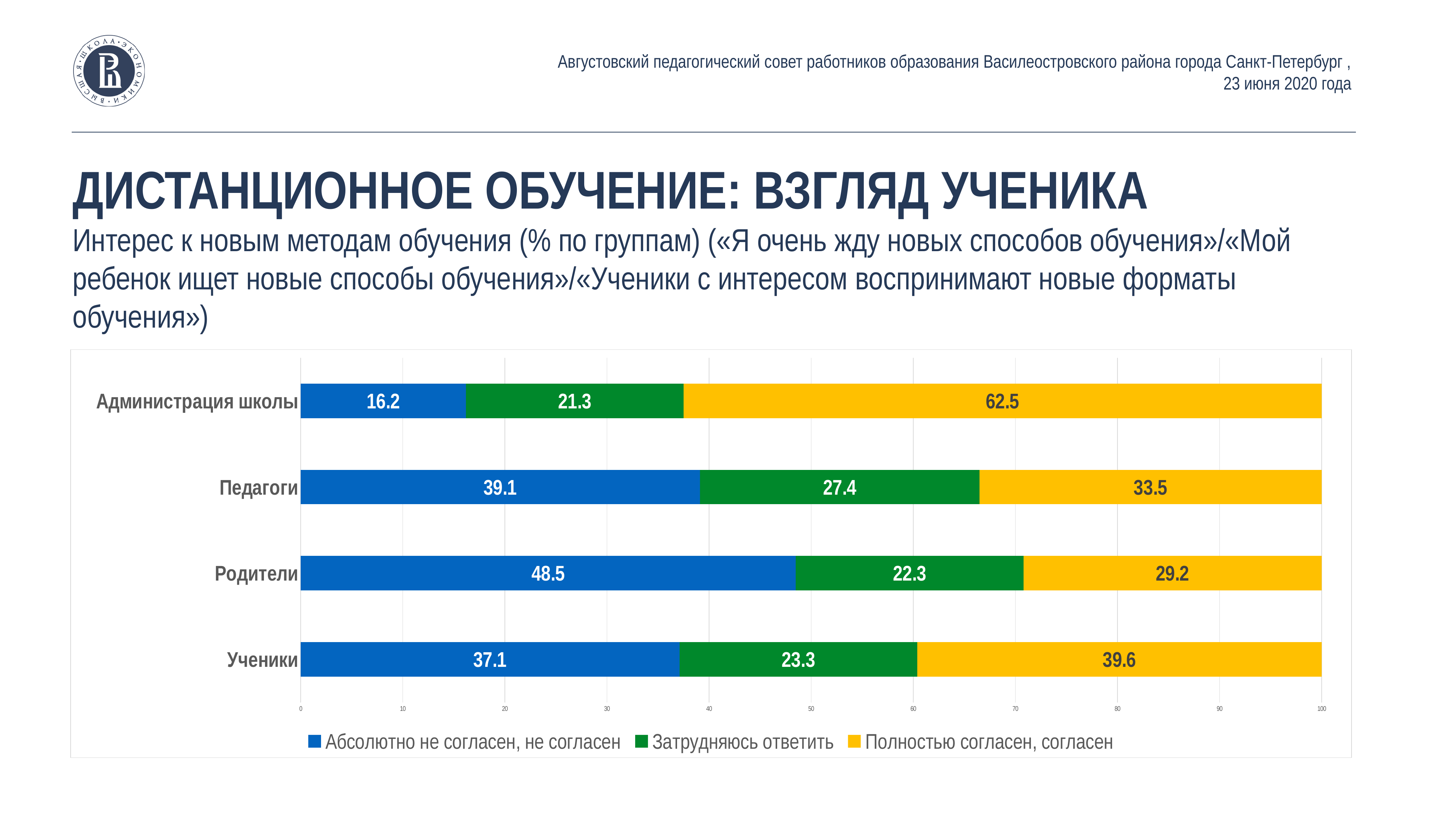
What is the value of «Полностью согласен, согласен» for Администрация школы? 62.5 What type of chart is shown on the slide? Stacked bar chart Which group has the highest value for «Полностью согласен, согласен»? Администрация школы How many series does the legend list? 3 What is the value of «Абсолютно не согласен, не согласен» for Родители? 48.5 Which is larger: the «Абсолютно не согласен, не согласен» value for Педагоги or for Ученики? Педагоги Which group has the lowest value for «Абсолютно не согласен, не согласен»? Администрация школы What is the difference between the «Полностью согласен, согласен» values for Ученики and Родители? 10.4 What is the total of the stacked bar for Педагоги? 100 How many groups (categories) are shown on the chart? 4 Which colour represents «Затрудняюсь ответить» in the chart? Green What is the value of «Затрудняюсь ответить» for Педагоги? 27.4